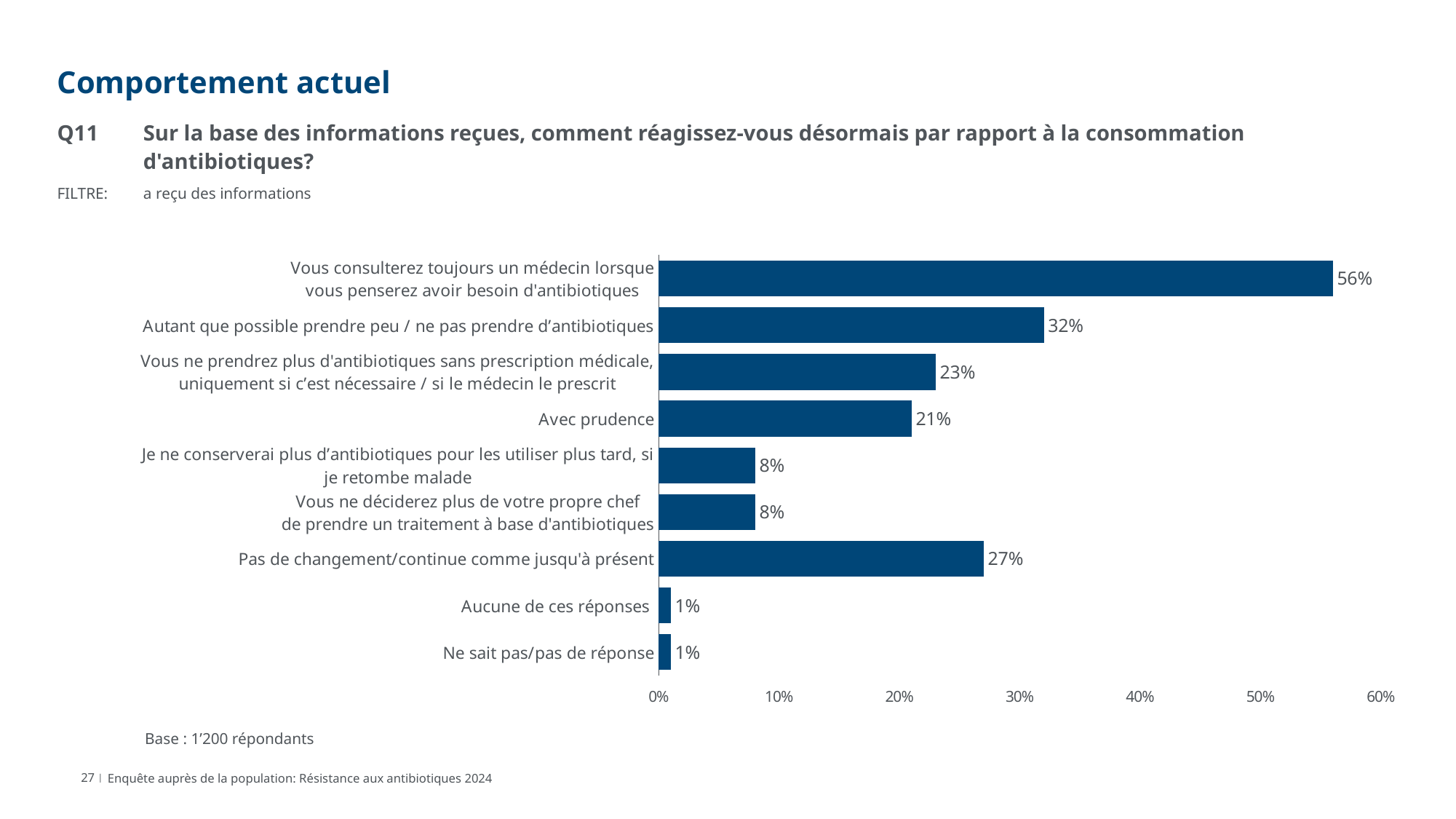
What is the value for "Pas de changement/continue comme jusqu'à présent"? 27% What is the difference between the values for "Vous consulterez toujours un médecin lorsque vous penserez avoir besoin d'antibiotiques" and "Autant que possible prendre peu / ne pas prendre d'antibiotiques"? 24% Which category has the highest value? Vous consulterez toujours un médecin lorsque vous penserez avoir besoin d'antibiotiques Which is larger: the value for "Pas de changement/continue comme jusqu'à présent" or the value for "Vous ne prendrez plus d'antibiotiques sans prescription médicale, uniquement si c'est nécessaire / si le médecin le prescrit"? Pas de changement/continue comme jusqu'à présent What is the value for "Avec prudence"? 21% How many categories are shown in the chart? 9 What is the value for "Je ne conserverai plus d'antibiotiques pour les utiliser plus tard, si je retombe malade"? 8% What kind of chart is shown on the slide? Bar chart Is the value for "Vous consulterez toujours un médecin lorsque vous penserez avoir besoin d'antibiotiques" greater or less than 50%? greater What is the highest value shown on the x axis? 60% What is the value for "Autant que possible prendre peu / ne pas prendre d'antibiotiques"? 32% What is the difference between the values for "Avec prudence" and "Aucune de ces réponses"? 20%